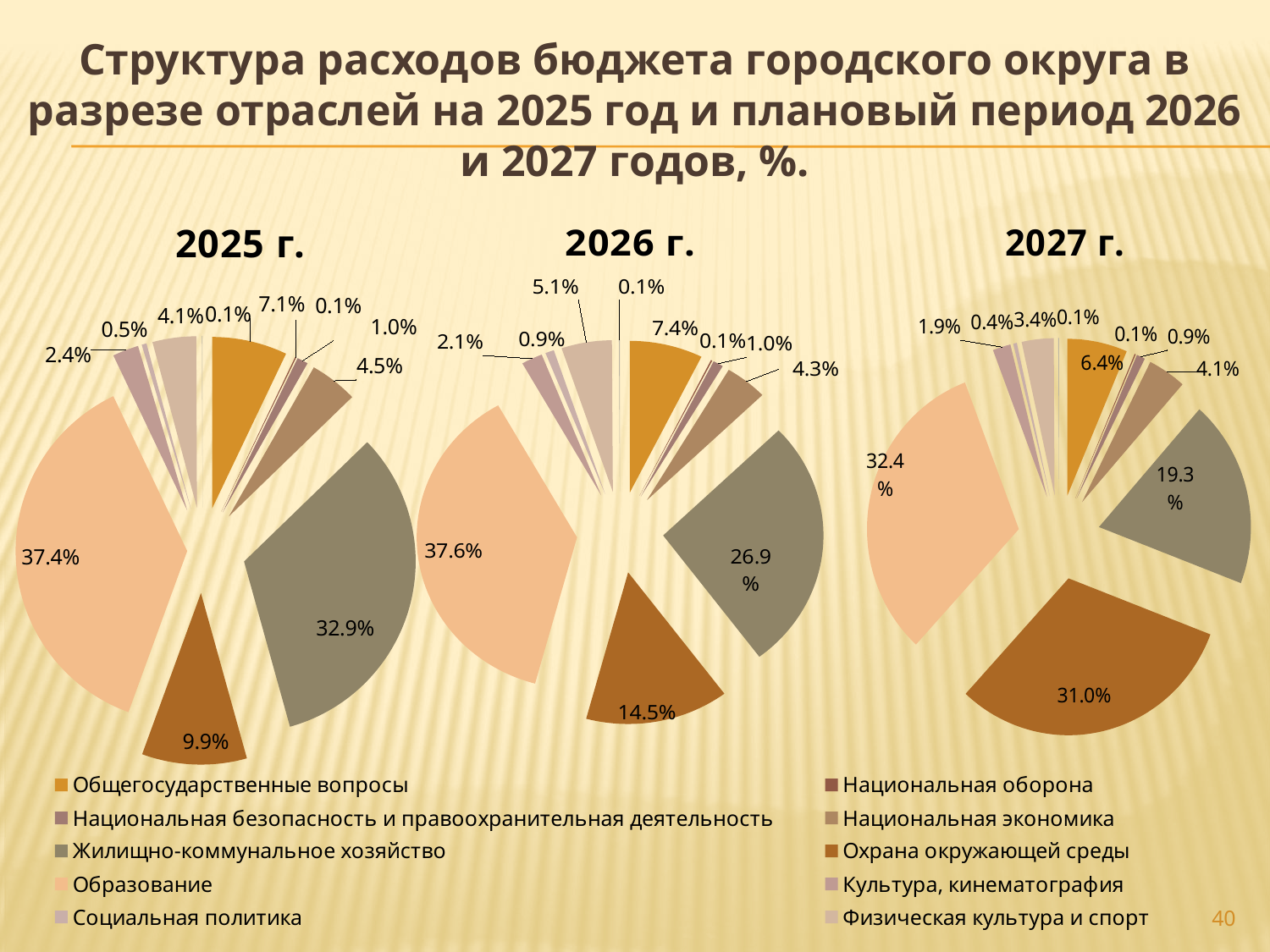
In the 2026 г. chart, which is larger: Жилищно-коммунальное хозяйство or Охрана окружающей среды? Жилищно-коммунальное хозяйство In the 2025 г. chart, what share is Жилищно-коммунальное хозяйство? 32.9% In the 2025 г. chart, what share is Образование? 37.4% In the 2027 г. chart, what share is Общегосударственные вопросы? 6.4% In the 2027 г. chart, which category has the largest share? Образование In the 2026 г. chart, what share is Охрана окружающей среды? 14.5% How many pie charts are on the slide? 3 In the 2027 г. chart, what share is Охрана окружающей среды? 31.0% In the 2026 г. chart, what share is Жилищно-коммунальное хозяйство? 26.9% What kind of charts are shown on the slide? Pie charts What is the difference between the Образование share in 2025 г. and in 2027 г.? 5.0% How many categories does the legend list? 10